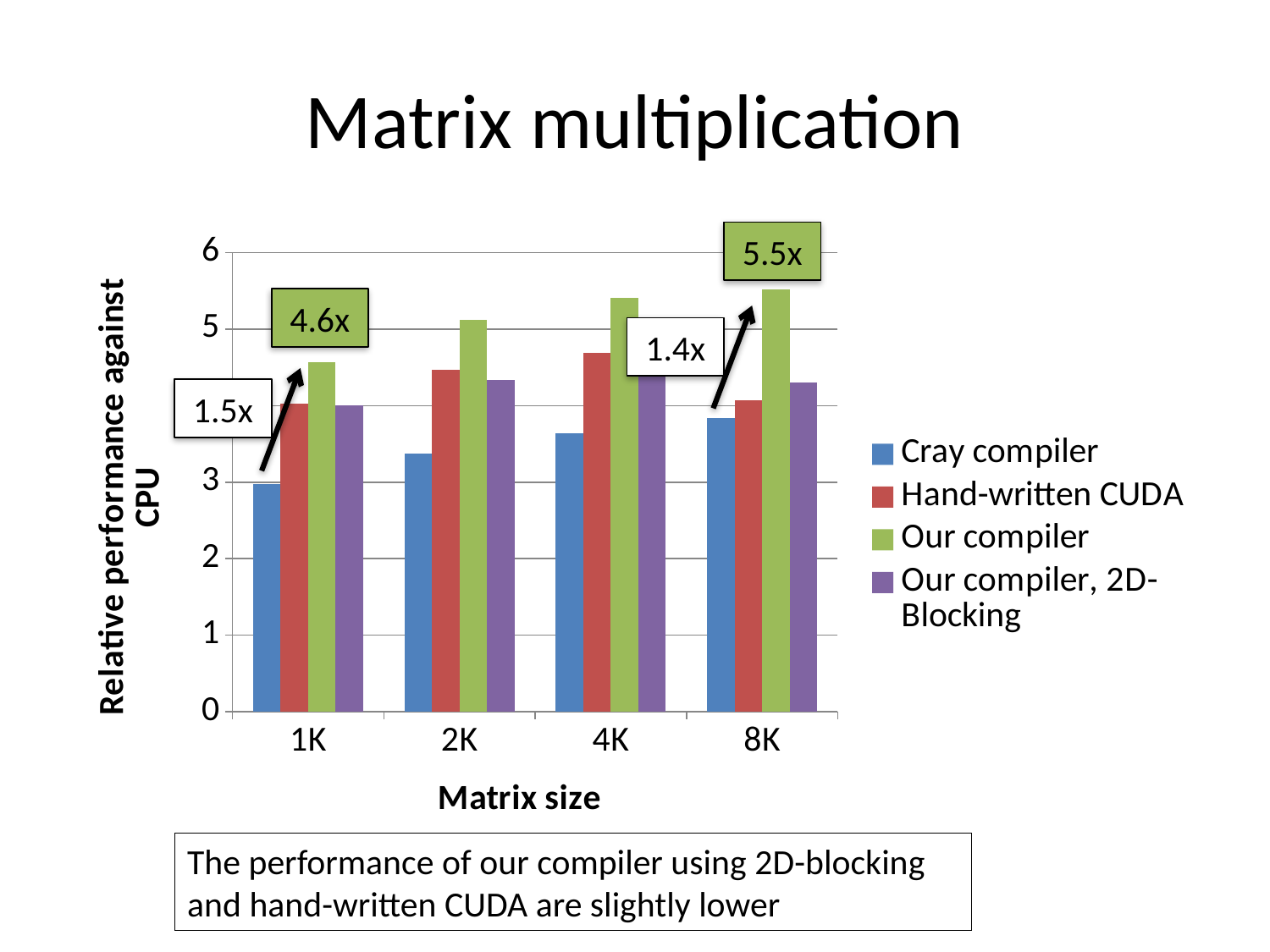
Is the value for the Cray compiler at matrix size 8K greater or less than 4? less Do the Cray compiler values rise or fall as the matrix size increases from 1K to 8K? rise Which is larger at matrix size 4K: Our compiler or Cray compiler? Our compiler What type of chart is shown on the slide? bar chart Is the value for Our compiler at matrix size 2K greater or less than 5? greater What is the label of the y axis? Relative performance against CPU Which series has the highest bar for matrix size 1K? Our compiler Which series has the lowest bar for matrix size 8K? Cray compiler What is the relative performance of Our compiler for matrix size 8K, as labelled on the chart? 5.5x What is the relative performance of Our compiler for matrix size 1K, as labelled on the chart? 4.6x How many series does the legend list? 4 How many matrix sizes are shown on the x axis? 4